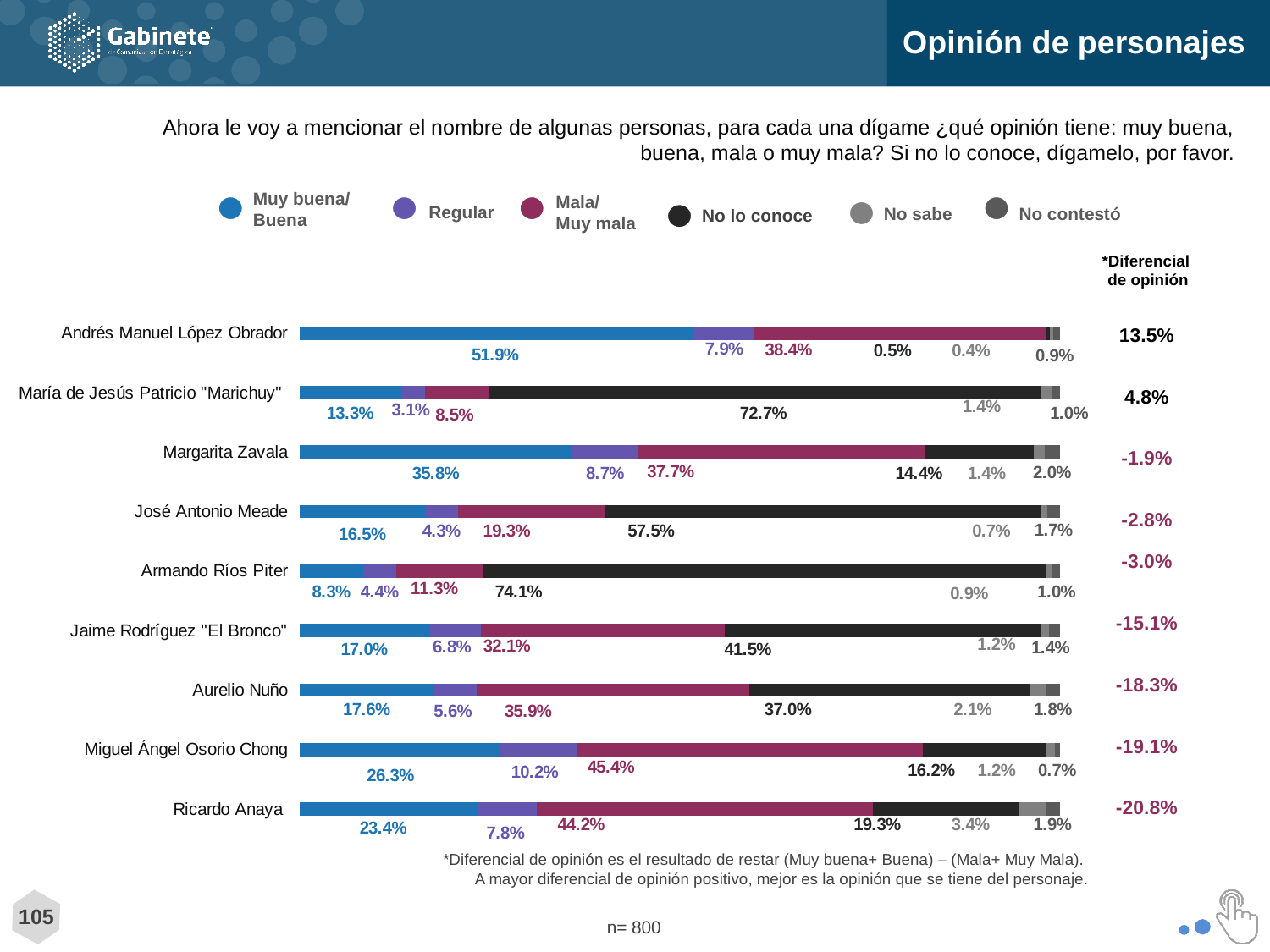
What percentage of respondents have a 'Muy buena/Buena' opinion of Andrés Manuel López Obrador? 51.9% What is the difference between the 'Muy buena/Buena' and 'Mala/Muy mala' values for Margarita Zavala? -1.9% How many people are listed in the chart? 9 What is the 'Mala/Muy mala' value for Miguel Ángel Osorio Chong? 45.4% What kind of chart is shown on the slide? Stacked bar chart What is the 'Diferencial de opinión' shown for Ricardo Anaya? -20.8% How many series does the legend list? 6 Which person has the highest 'Muy buena/Buena' value? Andrés Manuel López Obrador What is the sample size (n) shown on the slide? 800 Who has a larger 'No lo conoce' value, Armando Ríos Piter or José Antonio Meade? Armando Ríos Piter Which person has the lowest 'No lo conoce' value? Andrés Manuel López Obrador What is the 'No lo conoce' value for María de Jesús Patricio "Marichuy"? 72.7%